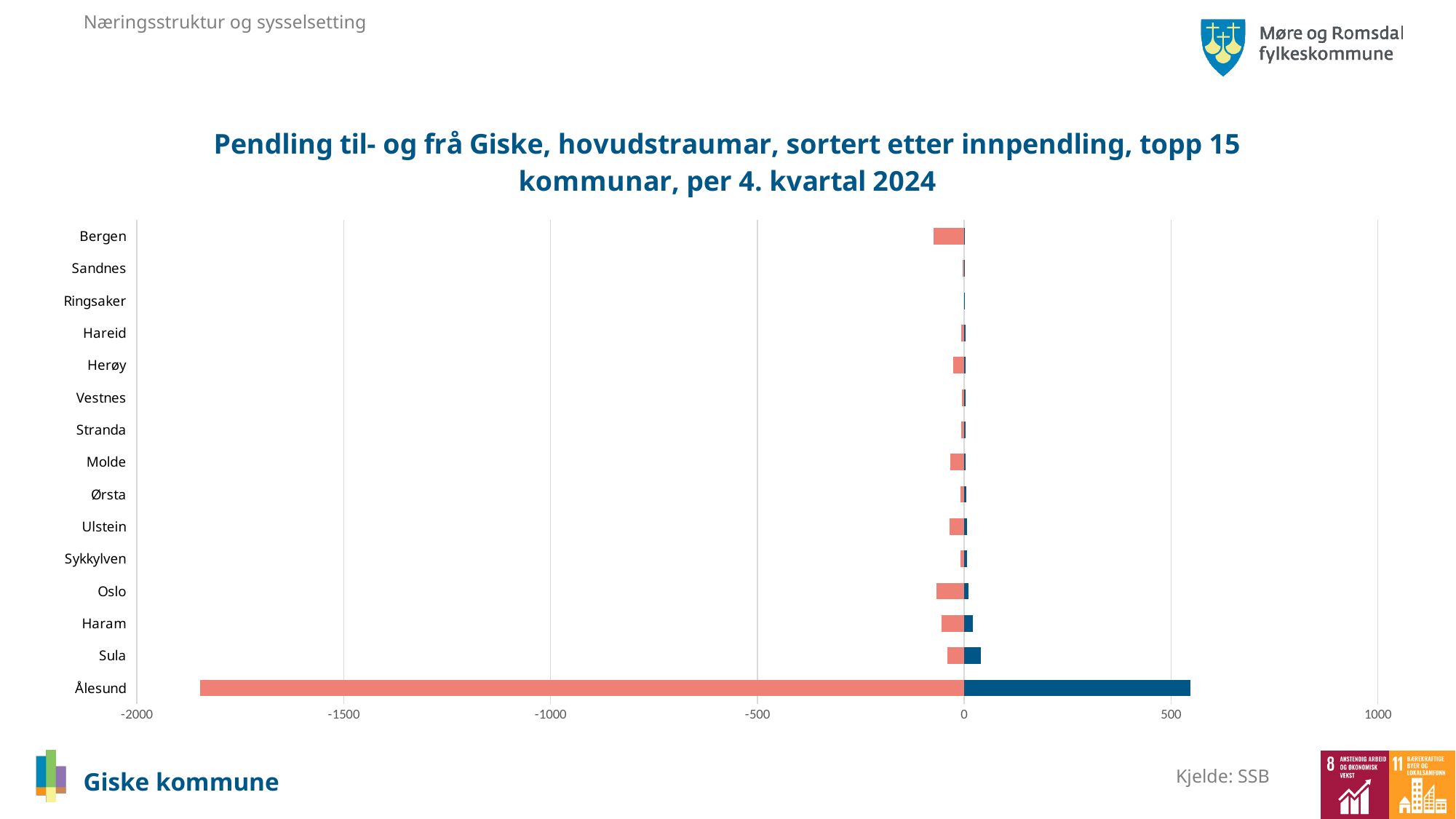
Which municipality is listed at the top of the vertical axis? Bergen Is the blue (positive) bar for Ålesund greater or less than 500? greater What is the lowest value shown on the horizontal axis of the chart? -2000 What kind of chart is shown on the slide? bar chart Which has the longer red (negative) bar, Ålesund or Oslo? Ålesund Which has the longer red (negative) bar, Bergen or Sandnes? Bergen How many municipalities (categories) are listed on the vertical axis of the chart? 15 Is the red (negative) bar for Ålesund greater or less than -1500? less Which has the longer blue (positive) bar, Sula or Haram? Sula Is the red bar for Bergen greater or less than -500? greater Which municipality has the longest bars in the chart? Ålesund